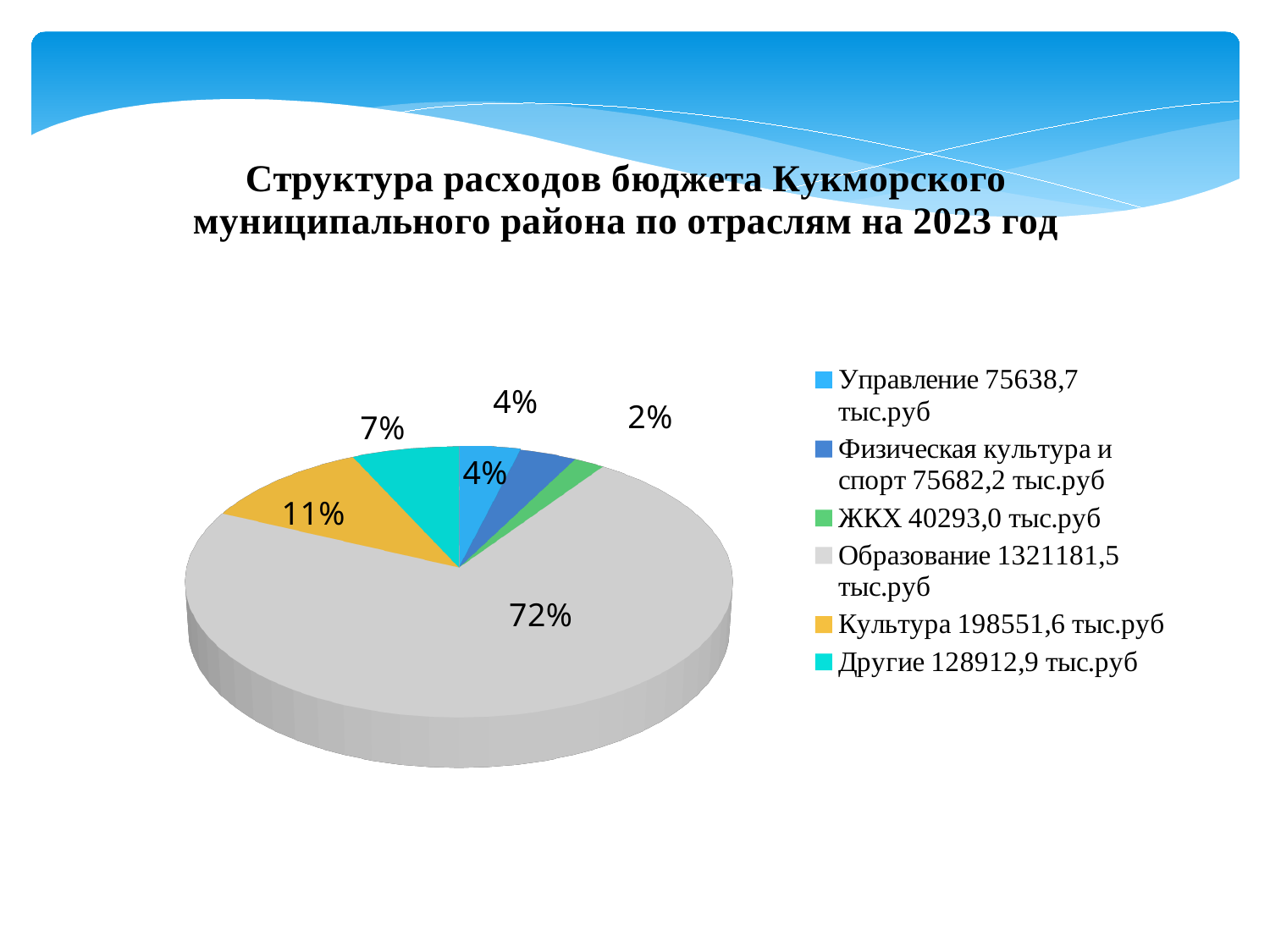
What share of the pie does Образование take? 72% What amount in тыс.руб does the legend give for Культура? 198551,6 тыс.руб Which slice is larger, Культура or Другие? Культура Which category has the largest slice of the pie? Образование What share of the pie does Другие take? 7% How many slices does the pie chart have? 6 Which category has the smallest slice of the pie? ЖКХ What share of the pie does Культура take? 11% What type of chart is shown on the slide? pie chart What is the difference in percentage points between the Образование slice and the Культура slice? 61 What amount in тыс.руб does the legend give for Образование? 1321181,5 тыс.руб